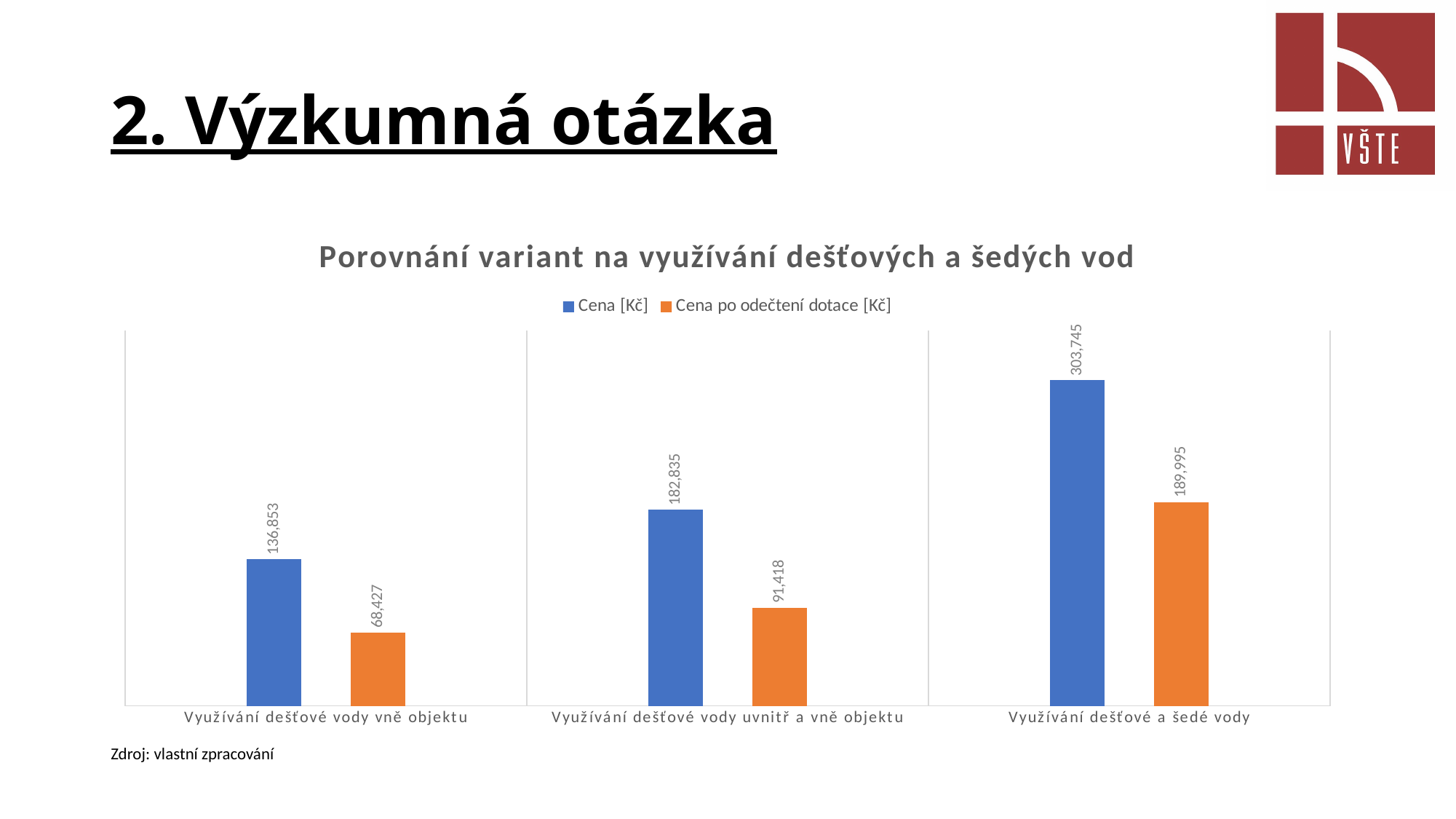
What is the value of Cena po odečtení dotace [Kč] for Využívání dešťové a šedé vody? 189,995 What is the title of the chart? Porovnání variant na využívání dešťových a šedých vod How many series does the legend list? 2 Which category has the lowest Cena po odečtení dotace [Kč]? Využívání dešťové vody vně objektu Which category has the highest Cena [Kč]? Využívání dešťové a šedé vody What is the value of Cena [Kč] for Využívání dešťové vody vně objektu? 136,853 Do the Cena [Kč] values rise or fall from left to right across the categories? Rise What is the value of Cena po odečtení dotace [Kč] for Využívání dešťové vody uvnitř a vně objektu? 91,418 How many categories are shown on the x axis? 3 What is the difference between Cena [Kč] and Cena po odečtení dotace [Kč] for Využívání dešťové a šedé vody? 113,750 Which is larger: Cena [Kč] for Využívání dešťové vody uvnitř a vně objektu or Cena po odečtení dotace [Kč] for Využívání dešťové a šedé vody? Cena po odečtení dotace [Kč] for Využívání dešťové a šedé vody What type of chart is shown on the slide? Bar chart